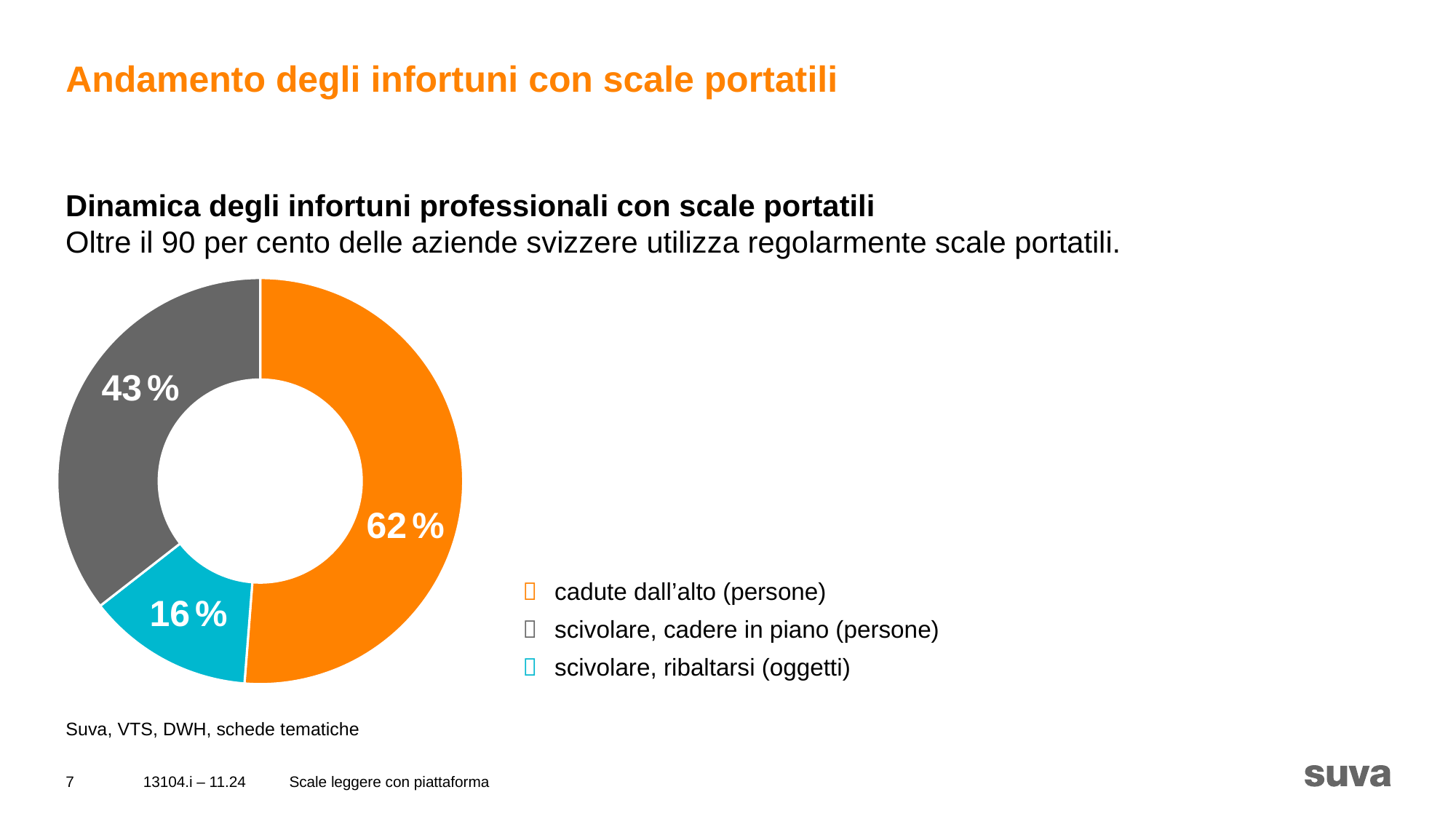
Which category has the smallest slice in the chart? scivolare, ribaltarsi (oggetti) What is the title of the slide containing the chart? Andamento degli infortuni con scale portatili Which category has the largest slice in the chart? cadute dall'alto (persone) What percentage does the chart show for scivolare, ribaltarsi (oggetti)? 16 % What percentage does the chart show for scivolare, cadere in piano (persone)? 43 % What percentage of the pie chart is for cadute dall'alto (persone)? 62 % What kind of chart is shown on the slide? pie chart (donut) What is the difference in percentage points between cadute dall'alto (persone) and scivolare, cadere in piano (persone)? 19 Which is larger: the slice for scivolare, cadere in piano (persone) or the slice for scivolare, ribaltarsi (oggetti)? scivolare, cadere in piano (persone) How many slices does the chart have? 3 What is the difference in percentage points between scivolare, cadere in piano (persone) and scivolare, ribaltarsi (oggetti)? 27 What colour is the slice for scivolare, ribaltarsi (oggetti)? cyan